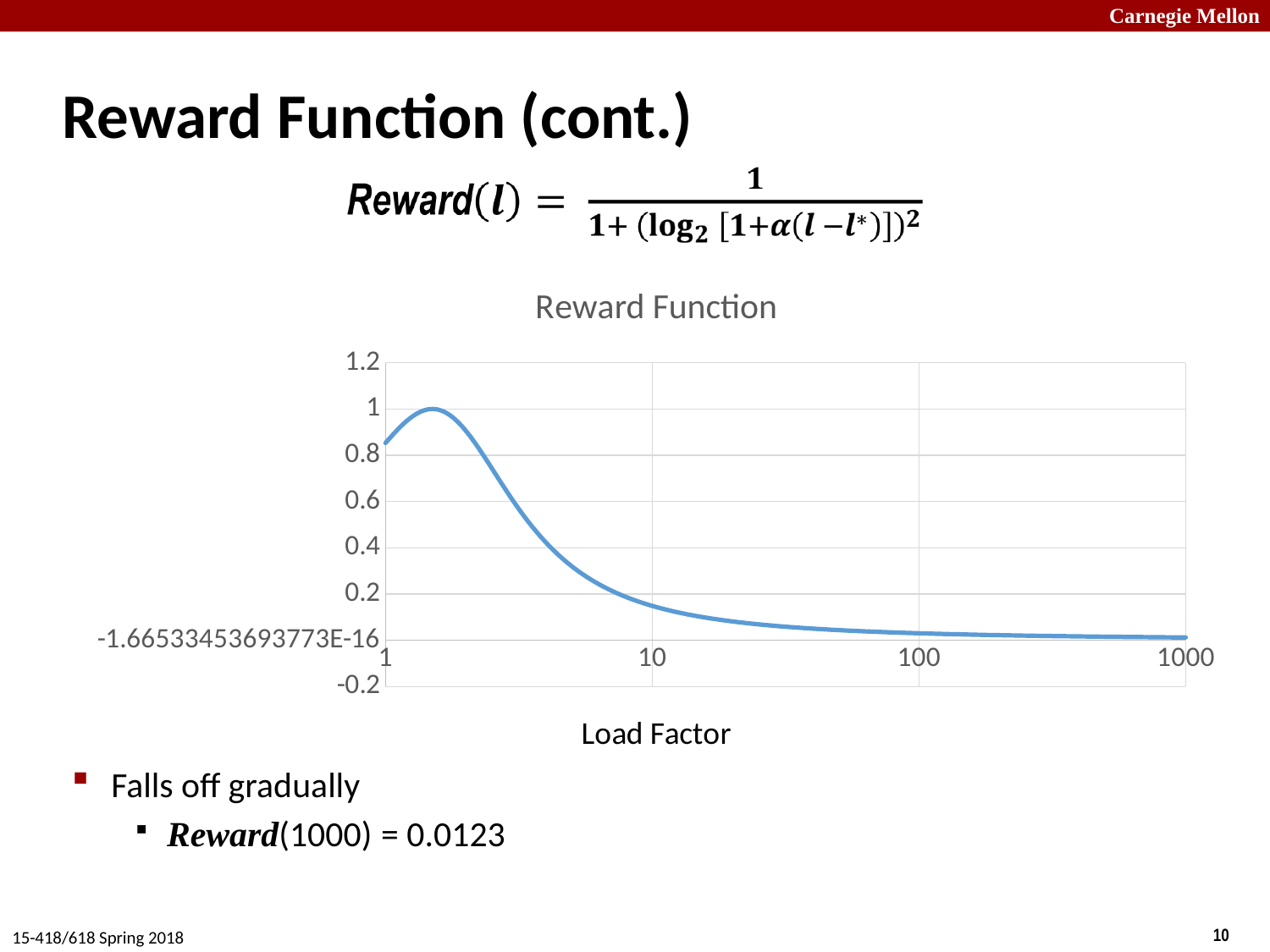
What is the label on the x axis of the chart? Load Factor Is the plotted value at a load factor of 1 greater or less than 0.6? greater According to the slide, what is the value of Reward(1000)? 0.0123 Between a load factor of 10 and a load factor of 1000, does the plotted value rise or fall? fall What is the title of the chart? Reward Function Which has the larger plotted value: a load factor of 1 or a load factor of 100? 1 Is the peak value of the curve greater or less than 0.8? greater What is the lowest tick value shown on the y axis? -0.2 How many tick labels are shown on the x axis? 4 What kind of chart is shown on the slide? line chart Is the plotted value at a load factor of 100 greater or less than 0.2? less What is the highest tick value shown on the y axis? 1.2